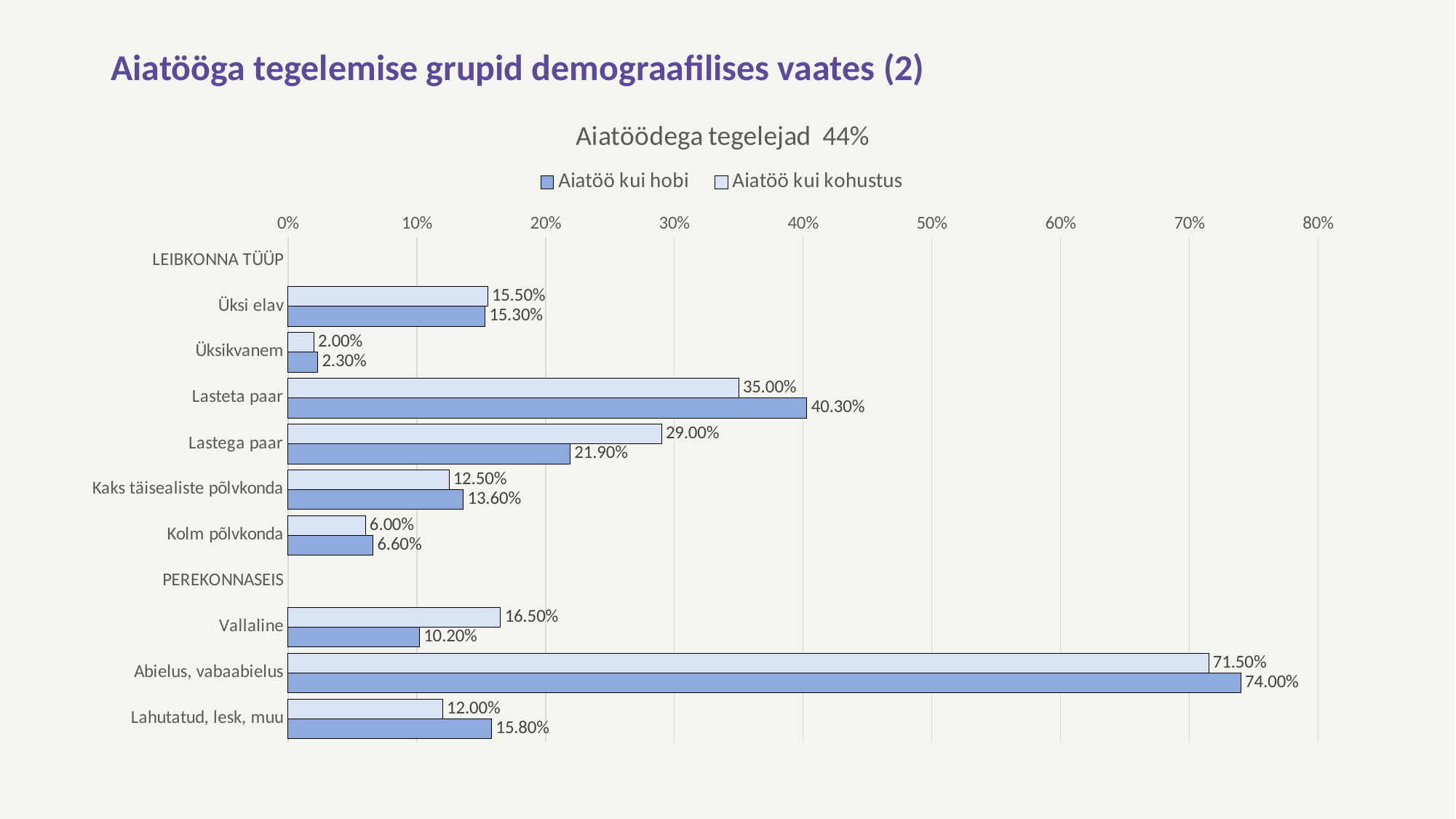
How many series does the legend list? 2 What is the value of "Aiatöö kui kohustus" for "Lastega paar"? 29.00% What percentage is shown in the chart title next to "Aiatöödega tegelejad"? 44% What is the value of "Aiatöö kui hobi" for "Lasteta paar"? 40.30% Which category has the lowest value for "Aiatöö kui kohustus"? Üksikvanem What type of chart is shown on the slide? bar chart Is the value of "Aiatöö kui hobi" for "Lasteta paar" greater or less than 30%? greater What is the value of "Aiatöö kui hobi" for "Vallaline"? 10.20% What is the difference between "Aiatöö kui hobi" and "Aiatöö kui kohustus" for "Abielus, vabaabielus"? 2.50% Which category has the highest value for "Aiatöö kui hobi"? Abielus, vabaabielus For "Lastega paar", which is larger: "Aiatöö kui hobi" or "Aiatöö kui kohustus"? Aiatöö kui kohustus What is the value of "Aiatöö kui kohustus" for "Üksikvanem"? 2.00%